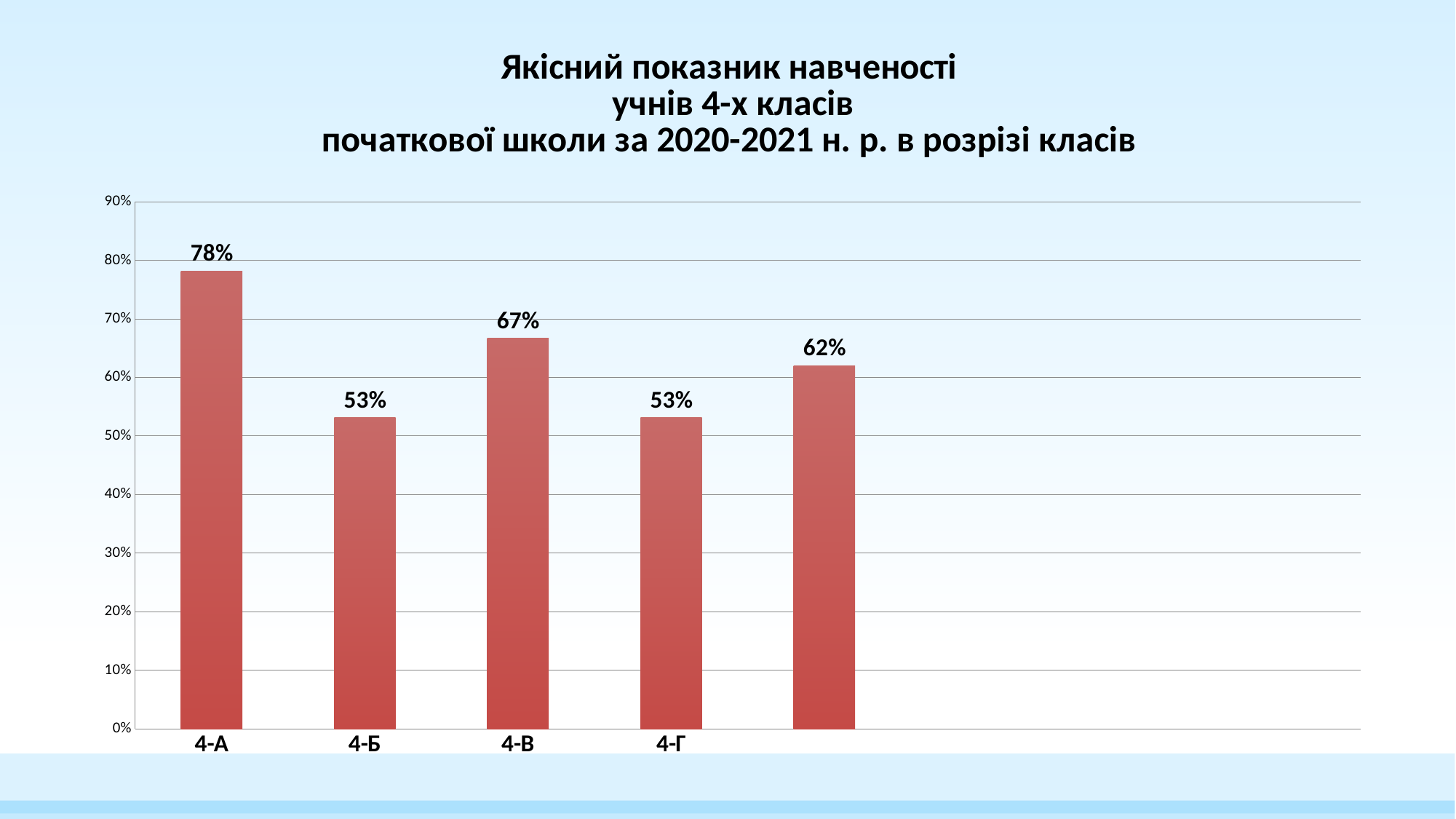
What is the value for 4-А? 78% Which is larger, the value for 4-Б or the value for 4-В? 4-В How many bars are plotted on the chart? 5 Which class has the highest value? 4-А What is the value for 4-Г? 53% What is the value for 4-В? 67% What is the difference between the values for 4-В and 4-Г? 14% What is the value for 4-Б? 53% What is the difference between the values for 4-А and 4-В? 11% What kind of chart is shown on the slide? bar chart What is the highest value shown on the vertical axis? 90% Is the value for 4-А greater or less than 70%? greater